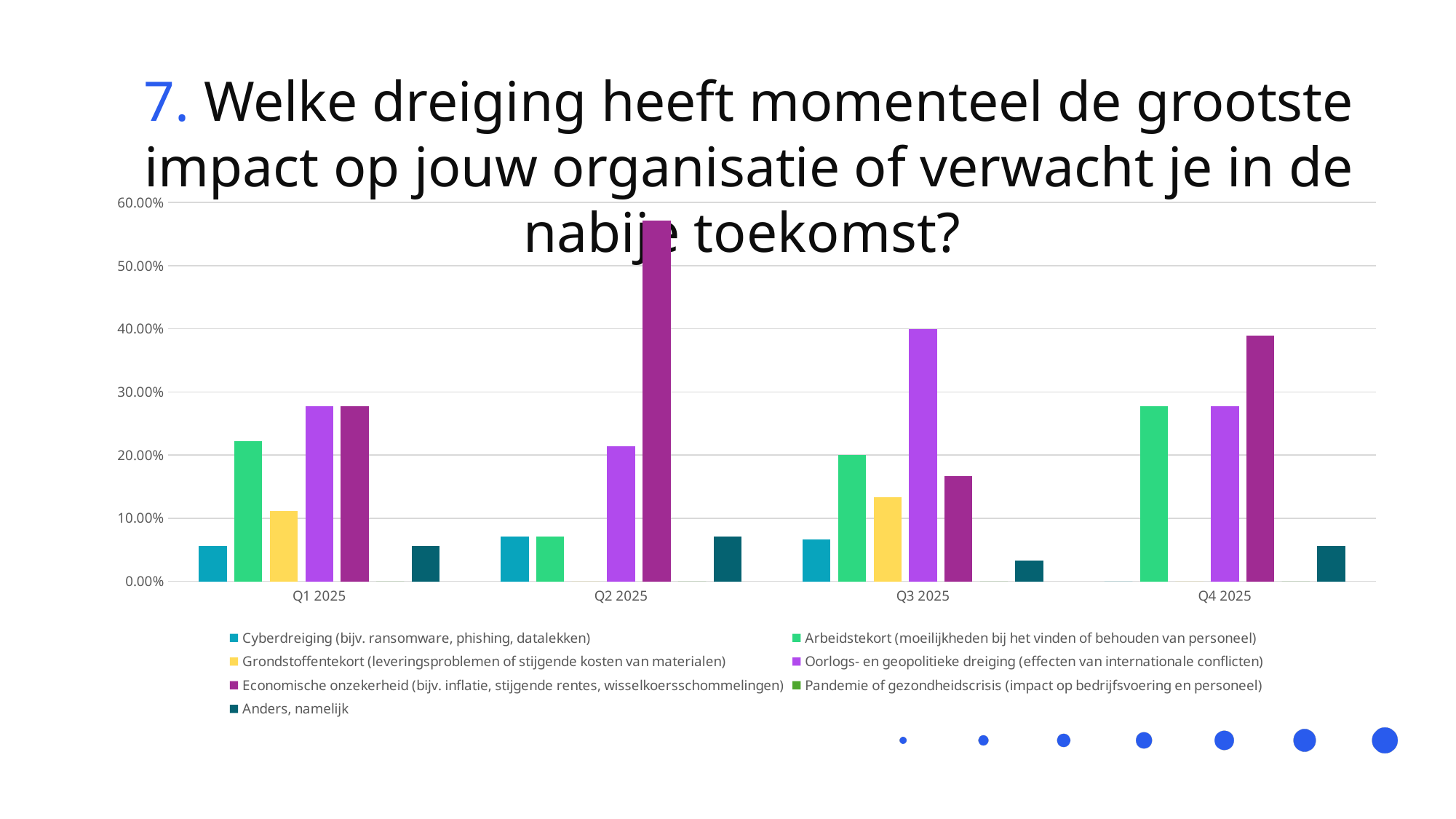
What kind of chart is shown on the slide? Bar chart Is the value for Grondstoffentekort in Q1 2025 greater or less than 20.00%? less Is the value for Economische onzekerheid in Q2 2025 greater or less than 50.00%? greater How many quarters are shown on the x axis of the chart? 4 What is the title of the chart on the slide? 7. Welke dreiging heeft momenteel de grootste impact op jouw organisatie of verwacht je in de nabije toekomst? In which quarter is the bar for Economische onzekerheid the highest? Q2 2025 In Q2 2025, which threat has the highest bar? Economische onzekerheid (bijv. inflatie, stijgende rentes, wisselkoersschommelingen) Is the value for Oorlogs- en geopolitieke dreiging in Q3 2025 greater or less than 30.00%? greater How many series does the chart's legend list? 7 In Q3 2025, which is larger: the bar for Arbeidstekort or the bar for Grondstoffentekort? Arbeidstekort Does the value for Economische onzekerheid rise or fall from Q2 2025 to Q3 2025? fall In Q3 2025, which threat has the highest bar? Oorlogs- en geopolitieke dreiging (effecten van internationale conflicten)